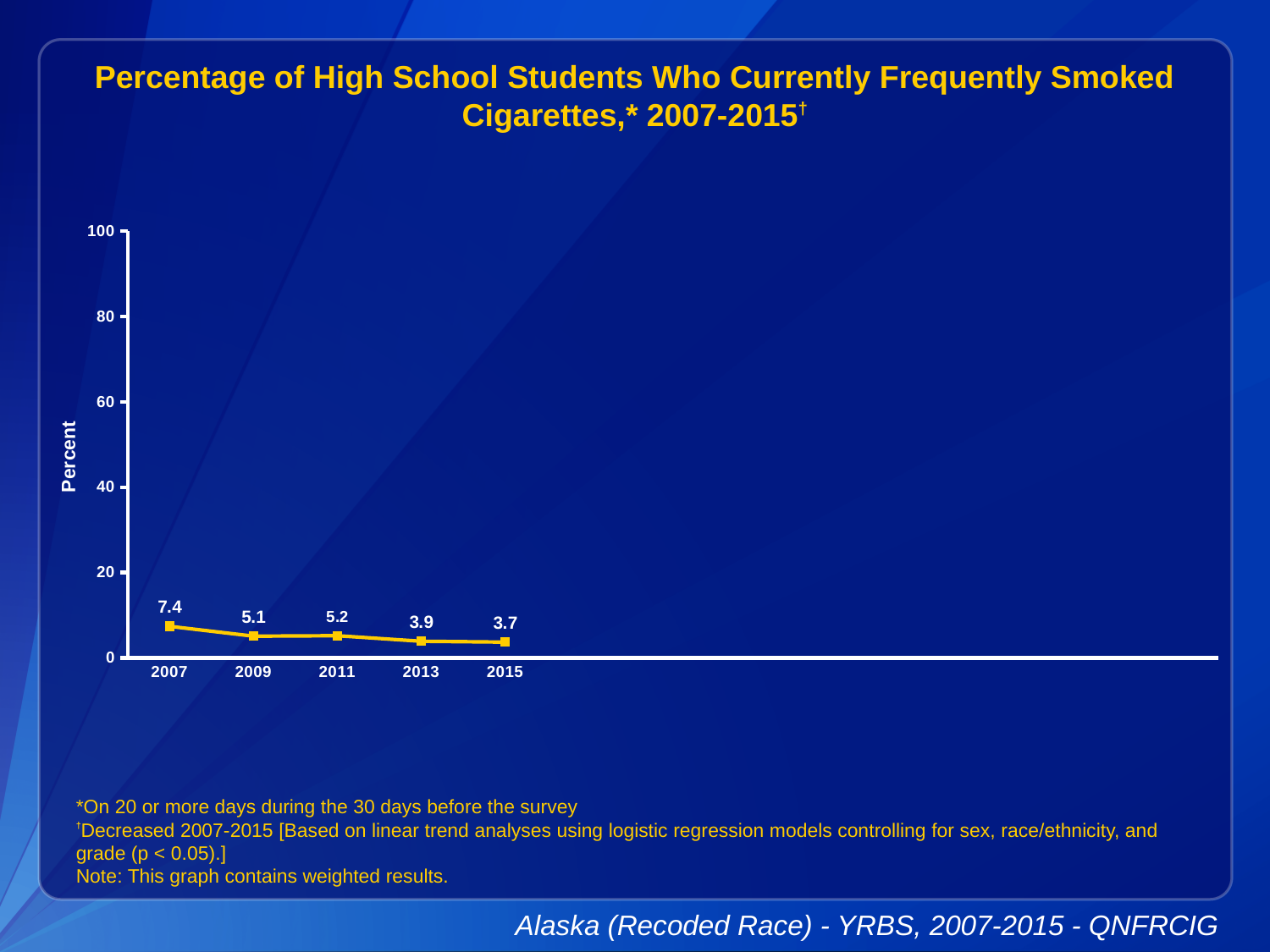
Do the values generally rise or fall from 2007 to 2015? fall Which year has the highest value? 2007 Which is larger, the value for 2009 or the value for 2013? 2009 What is the difference between the values for 2007 and 2015? 3.7 How many years are plotted on the chart? 5 What is the value for 2015? 3.7 What is the value for 2007? 7.4 Which year has the lowest value? 2015 What kind of chart is shown on the slide? line chart Is the value for 2007 greater or less than 20? less What is the value for 2011? 5.2 What is the label on the y axis? Percent